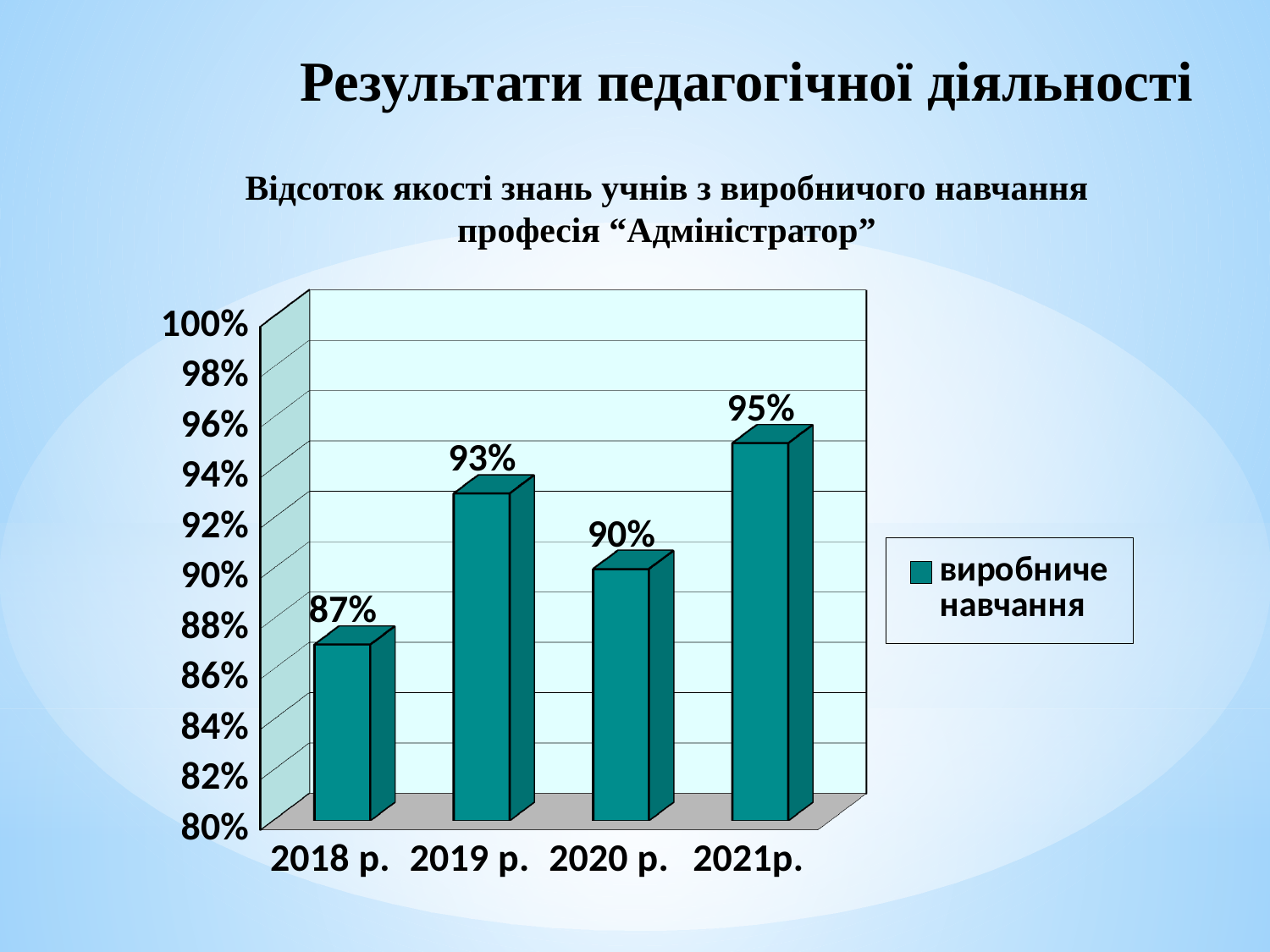
What is the value for 2020 р.? 90% What is the difference between the values for 2021р. and 2018 р.? 8% Which year has the lowest value? 2018 р. Which is larger, the value for 2019 р. or the value for 2020 р.? 2019 р. Which year has the highest value? 2021р. What series name is shown in the legend? виробниче навчання What is the difference between the values for 2019 р. and 2020 р.? 3% How many years are shown on the x axis? 4 What kind of chart is shown? bar chart How many series does the legend list? 1 What is the value for 2018 р.? 87% What is the value for 2021р.? 95%